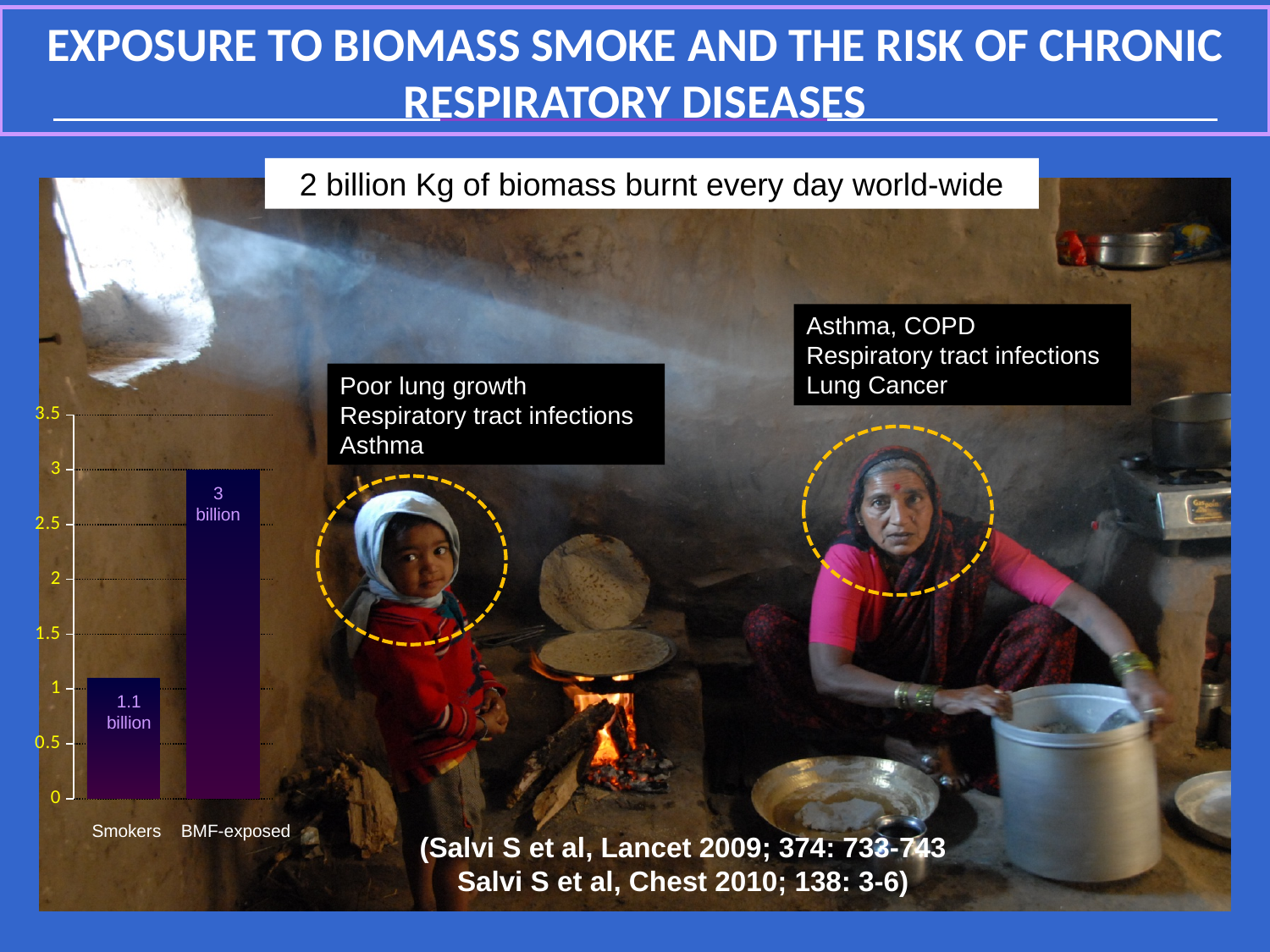
What is the maximum value shown on the y axis of the bar chart? 3.5 What value is shown for Smokers in the bar chart? 1.1 billion What value is shown for BMF-exposed in the bar chart? 3 billion What kind of chart is shown on the slide? bar chart How many categories are plotted in the bar chart? 2 Is the value for Smokers greater or less than 1.5? less What is the difference between the BMF-exposed value and the Smokers value? 1.9 billion What are the two category labels on the x axis of the bar chart? Smokers and BMF-exposed Is the value for BMF-exposed greater or less than 2.5? greater Which category has the higher bar, Smokers or BMF-exposed? BMF-exposed Which category has the lowest value in the bar chart? Smokers